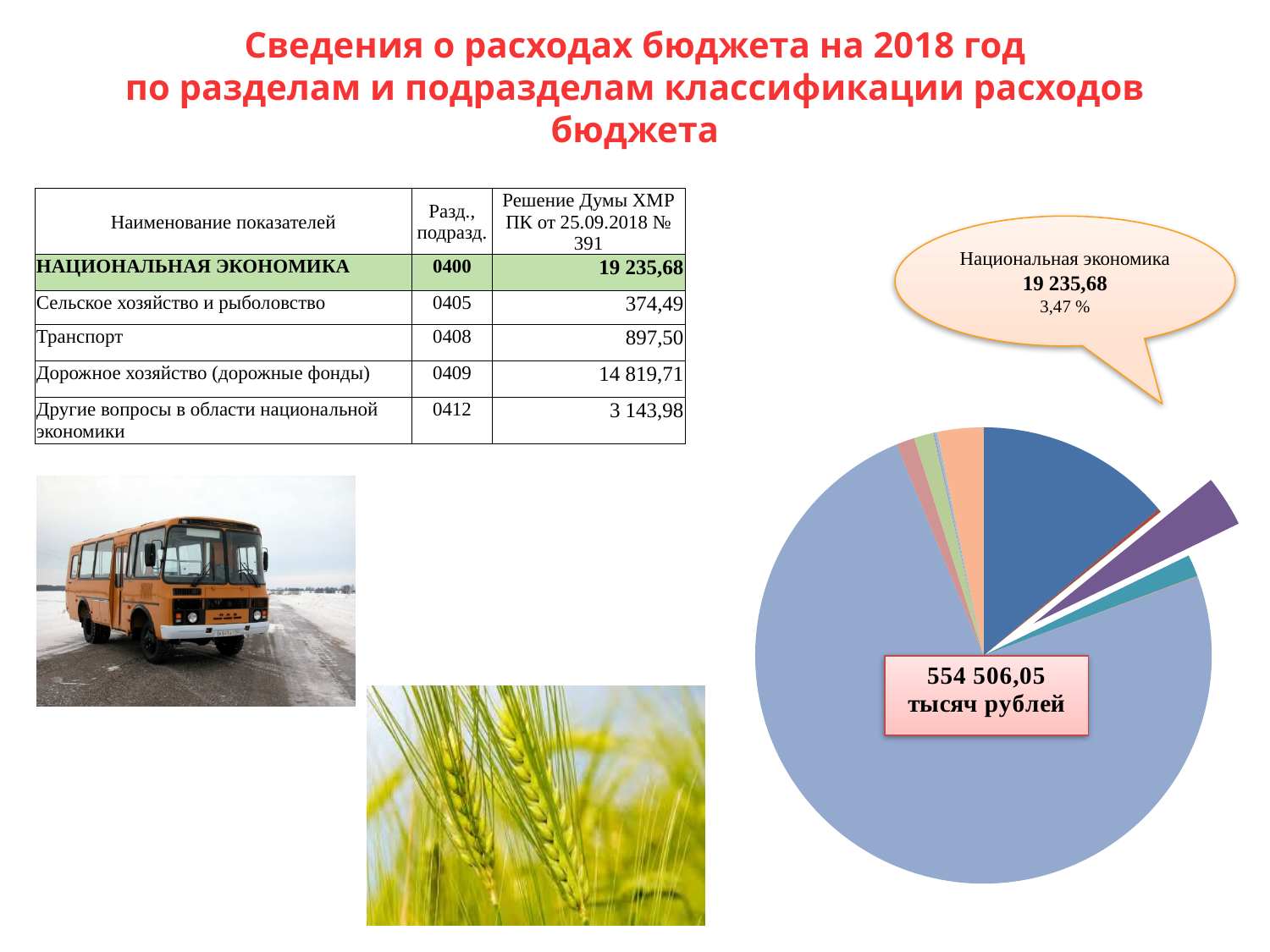
Does the pie chart have a legend listing its series? No What total amount is printed in the box on the pie chart? 554 506,05 тысяч рублей According to the callout on the pie chart, what is the value for Национальная экономика? 19 235,68 What share of the pie does the Национальная экономика slice represent, according to the callout? 3,47 % Is the share of Национальная экономика in the pie chart greater or less than 50%? less What kind of chart is shown on the right side of the slide? pie chart